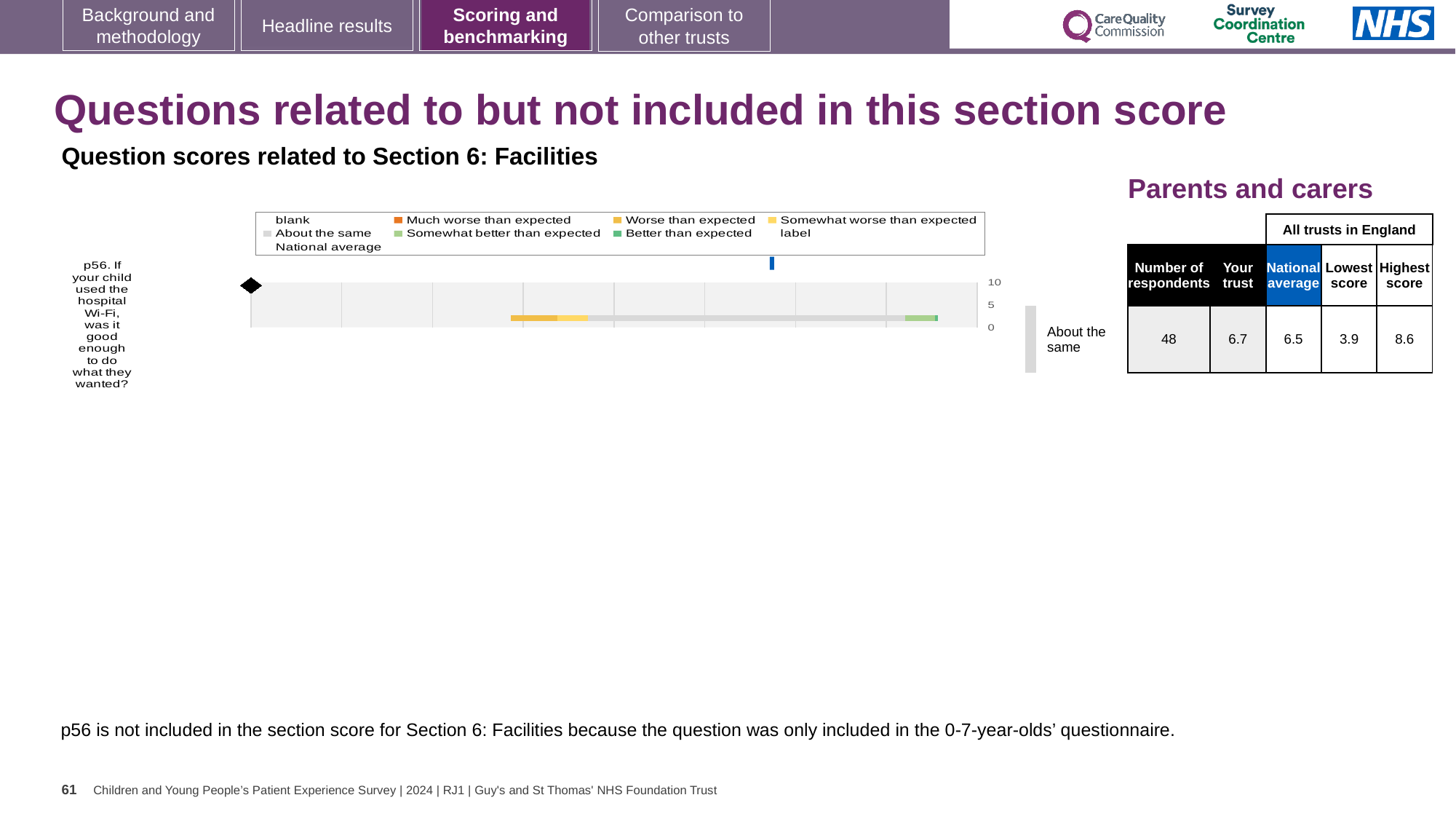
How many questions are plotted in the chart? 1 What is the highest value shown on the chart's score axis? 10 Which is larger for p56, the 'Your trust' score or the national average? Your trust What is the number of respondents for p56 shown next to the chart? 48 What kind of chart is used to show the p56 question score? Bar chart What is the highest score among all trusts in England for p56? 8.6 What is the difference between the highest and lowest scores for p56? 4.7 What is the lowest score among all trusts in England for p56? 3.9 By how much does the 'Your trust' score for p56 exceed the national average? 0.2 What benchmark category is the trust's p56 score placed in? About the same What is the national average score for p56? 6.5 What is the 'Your trust' score for p56? 6.7